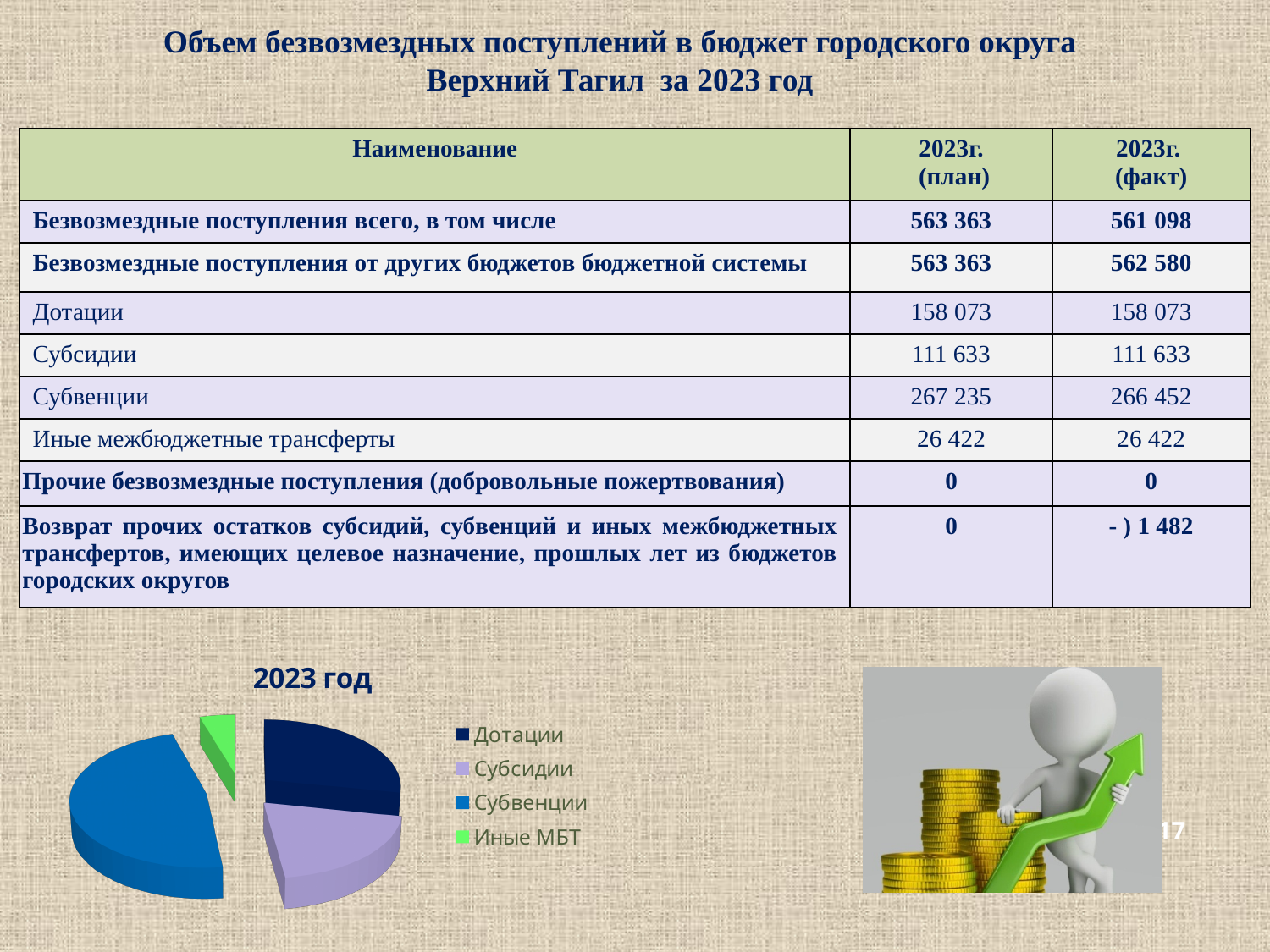
How many slices does the pie chart have? 4 What colour is the Иные МБТ slice in the pie chart? green What is the title of the pie chart? 2023 год What kind of chart is shown on the slide? pie chart How many entries does the pie chart legend list? 4 In the pie chart, which slice is larger: Субсидии or Иные МБТ? Субсидии In the pie chart, which slice is larger: Дотации or Иные МБТ? Дотации Which category has the smallest slice in the pie chart? Иные МБТ In the pie chart, which slice is larger: Субвенции or Дотации? Субвенции Which category has the largest slice in the pie chart? Субвенции